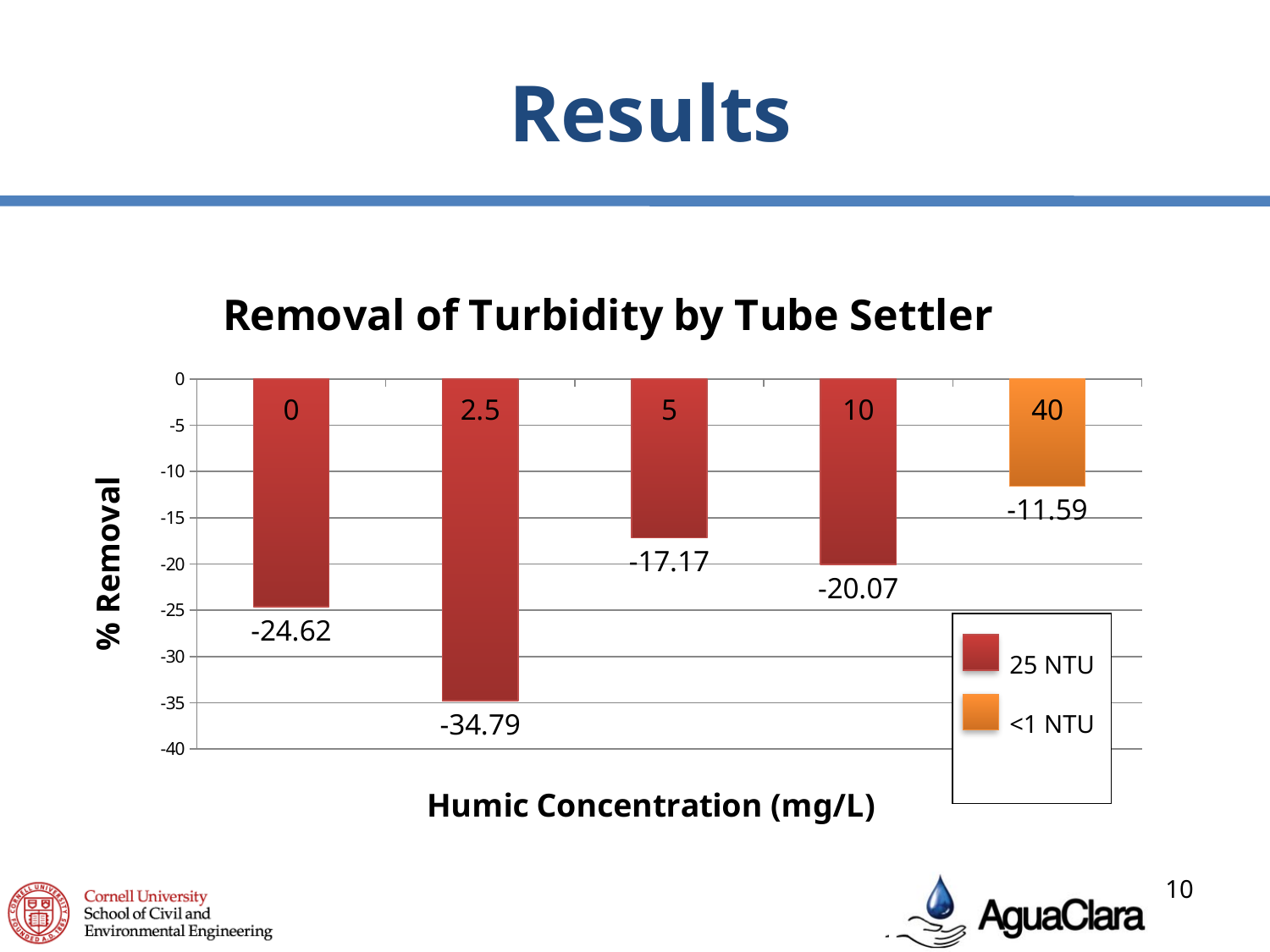
How many humic concentration categories are plotted in the chart? 5 How many series does the legend list? 2 What is the % Removal value for a humic concentration of 0 mg/L? -24.62 Which humic concentration has the highest % Removal value? 40 What kind of chart is shown on the slide? Bar chart What is the title of the chart? Removal of Turbidity by Tube Settler Which humic concentration bar belongs to the <1 NTU series? 40 What is the difference between the % Removal values at 5 mg/L and 10 mg/L? 2.90 Which humic concentration has the lowest (most negative) % Removal value? 2.5 Which has a larger % Removal value, the 0 mg/L bar or the 10 mg/L bar? 10 mg/L What is the % Removal value for a humic concentration of 40 mg/L? -11.59 What is the % Removal value for a humic concentration of 2.5 mg/L? -34.79